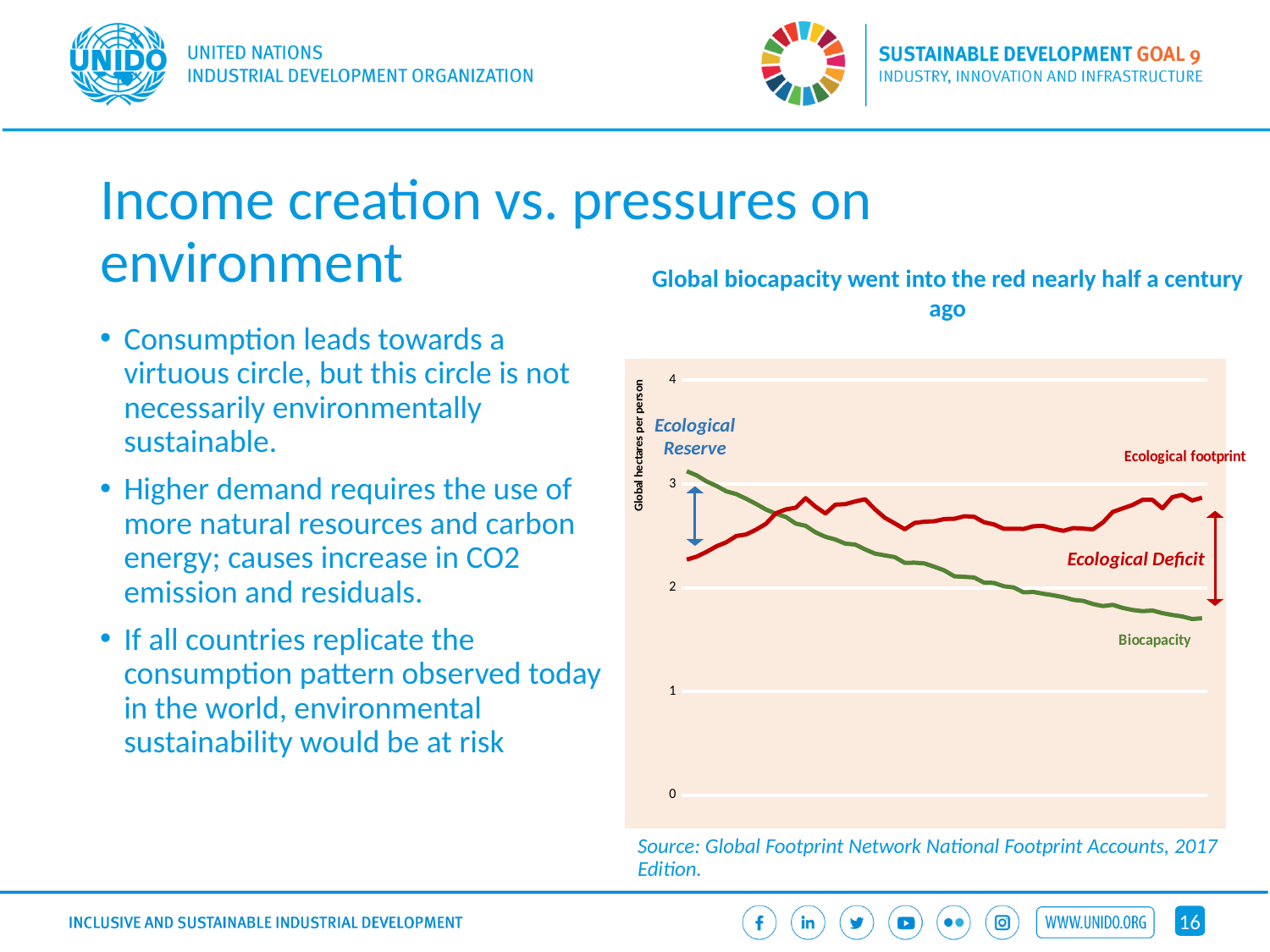
Is the value of Ecological footprint at the right end of the chart greater or less than 2? greater Is the value of Ecological footprint at the left end of the chart greater or less than 3? less What kind of chart is shown on the slide? line chart Does the Biocapacity line rise or fall from left to right? fall Does the Ecological footprint line generally rise or fall from left to right? rise At the right end of the chart, which series is higher: Ecological footprint or Biocapacity? Ecological footprint Is the value of Biocapacity at the right end of the chart greater or less than 2? less What is the label of the vertical axis of the chart? Global hectares per person At the left end of the chart, which series is higher: Ecological footprint or Biocapacity? Biocapacity Which series is drawn in green? Biocapacity How many data series are plotted in the chart? 2 What is the title of the chart? Global biocapacity went into the red nearly half a century ago